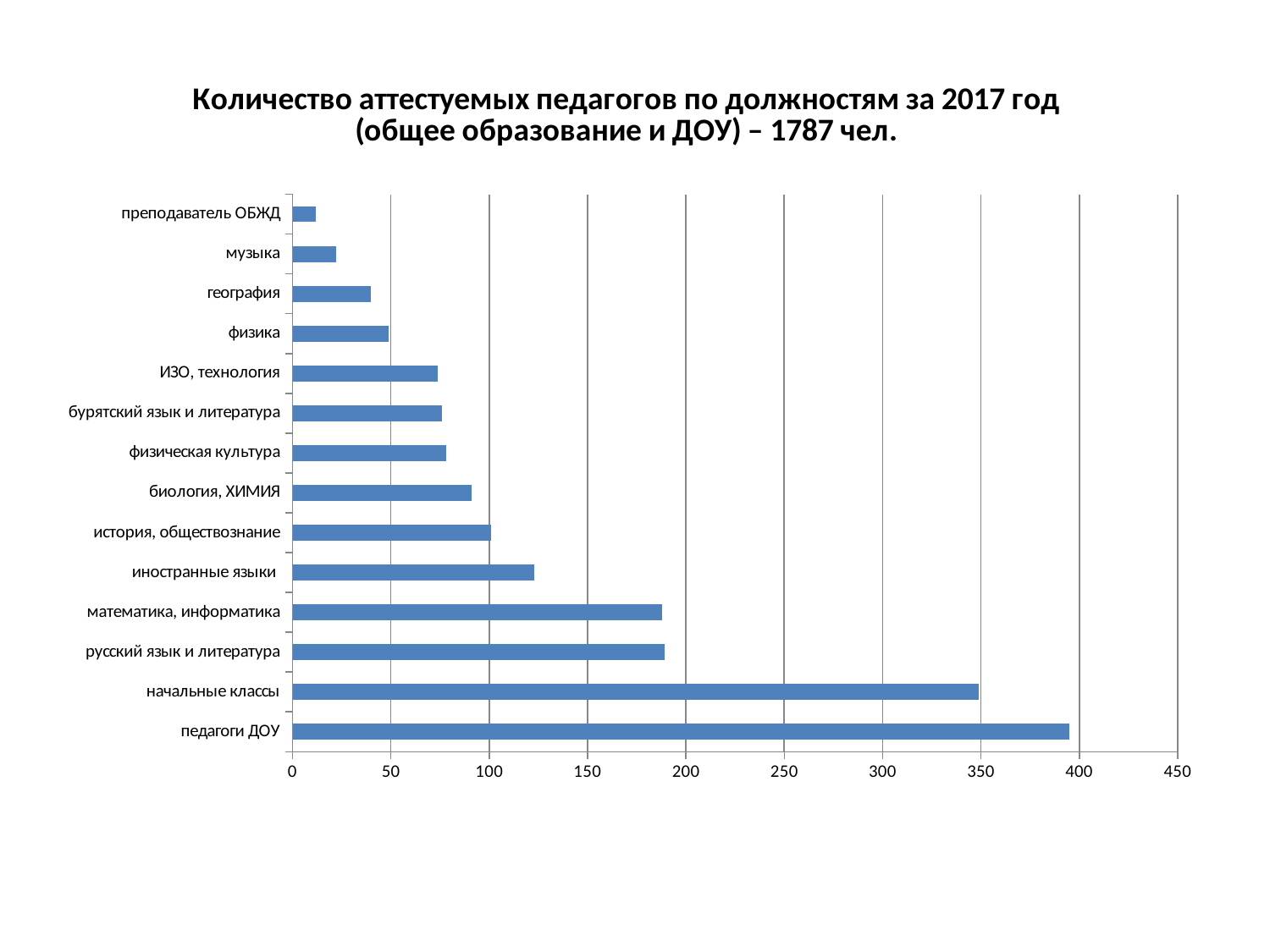
Is the value for начальные классы greater or less than 300? greater What total number of teachers is stated in the chart title? 1787 чел. Is the value for география greater or less than 50? less Is the value for педагоги ДОУ greater or less than 350? greater Which category has the lowest value? преподаватель ОБЖД Which is larger: the value for начальные классы or the value for русский язык и литература? начальные классы What kind of chart is shown on the slide? bar chart Which category has the highest value? педагоги ДОУ How many categories (positions) are plotted in the chart? 14 Which is larger: the value for музыка or the value for физика? физика